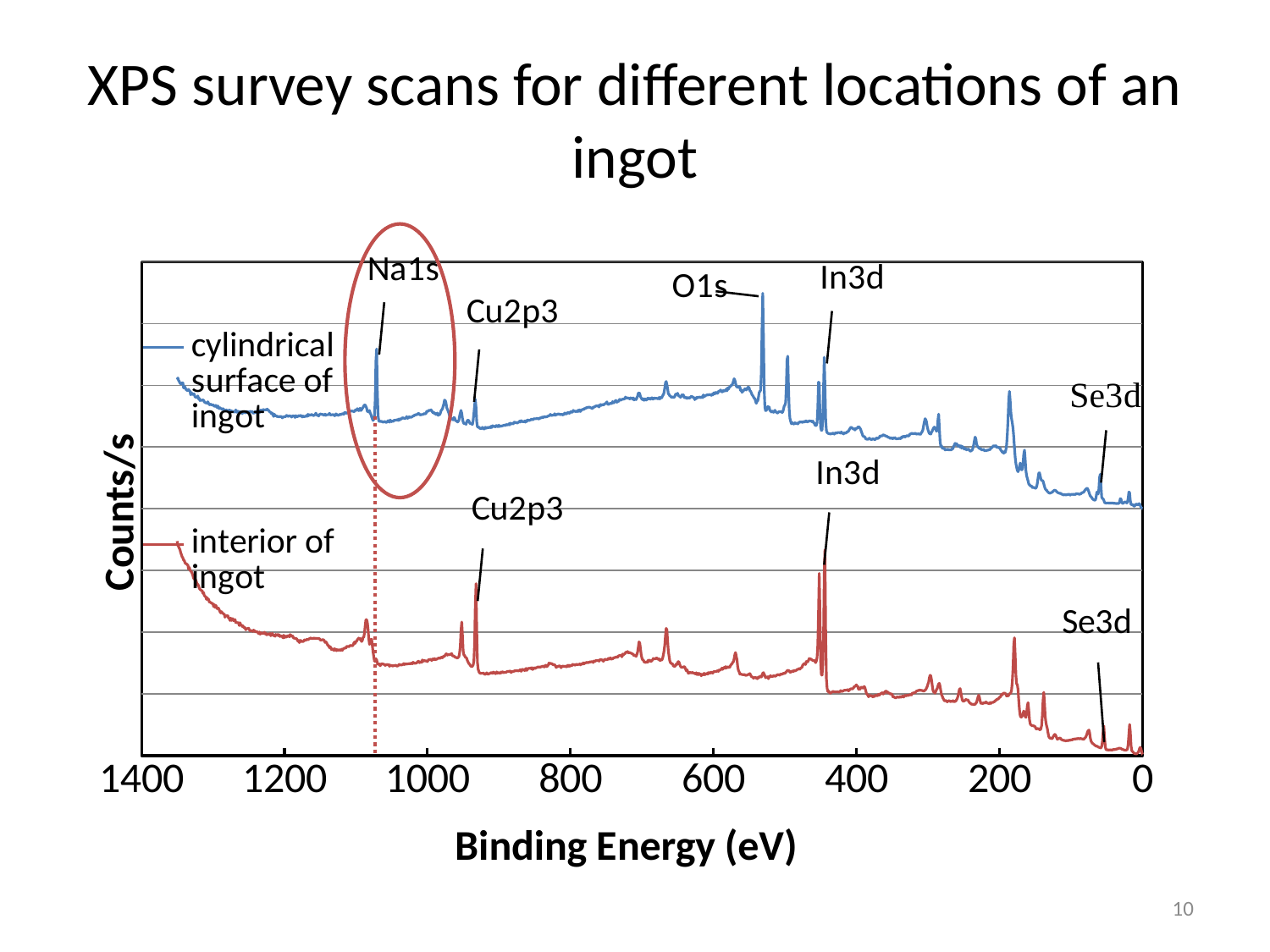
Which series is plotted higher on the chart, cylindrical surface of ingot or interior of ingot? cylindrical surface of ingot Which series shows the Na1s peak? cylindrical surface of ingot Which series shows the O1s peak? cylindrical surface of ingot What are the two series named in the legend? cylindrical surface of ingot; interior of ingot Which labeled peak is circled in red on the chart? Na1s How many series does the legend list? 2 Is the Se3d peak located at a binding energy greater or less than 200 eV? less How many peaks are labeled on the interior of ingot curve? 3 What kind of chart is shown on the slide? line chart Is the O1s peak located at a binding energy greater or less than 600 eV? less How many peaks are labeled on the cylindrical surface of ingot curve? 5 Is the Na1s peak located at a binding energy greater or less than 1000 eV? greater